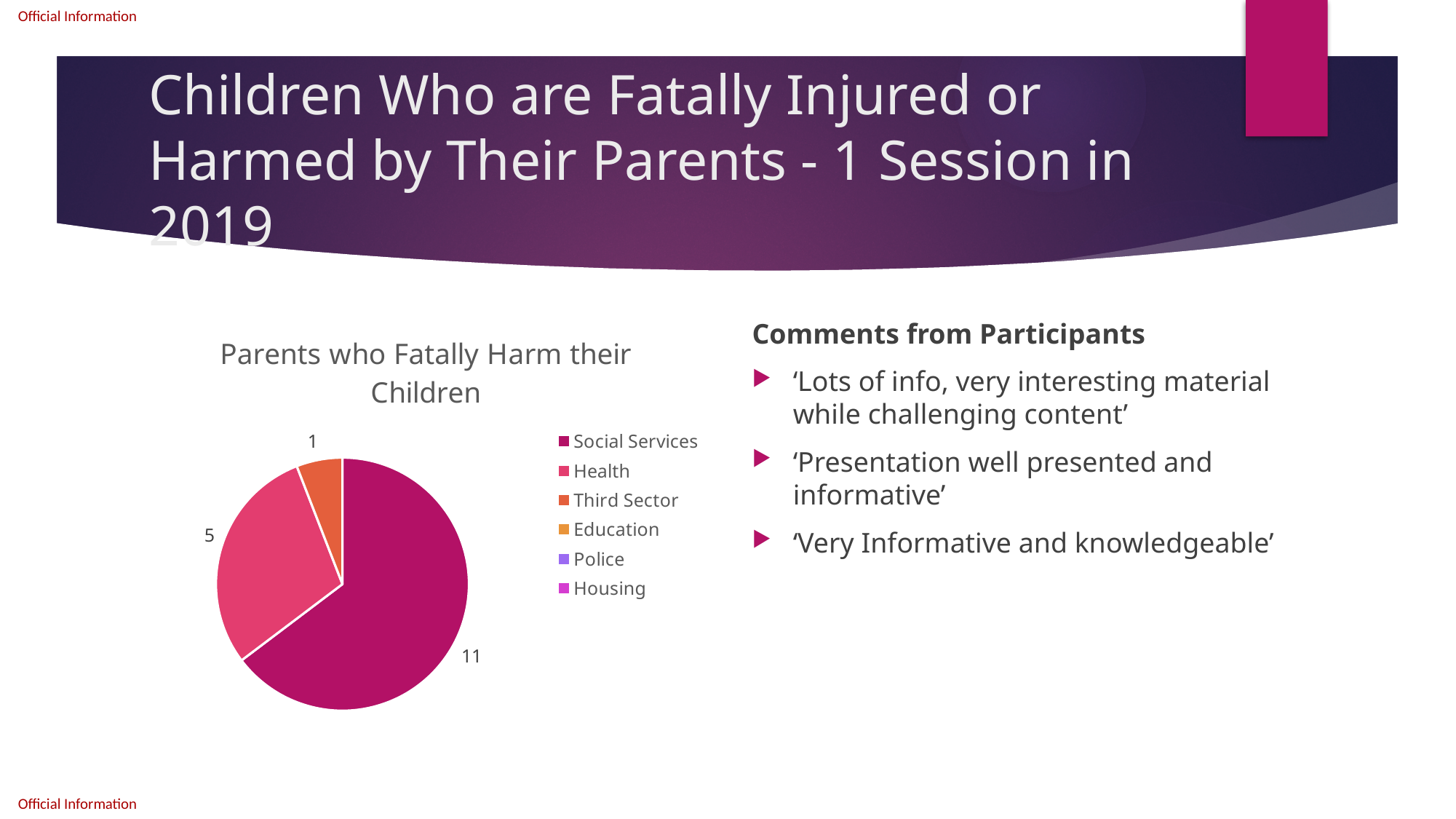
What is the title of the chart? Parents who Fatally Harm their Children Which of the labelled slices in the pie chart is the smallest? Third Sector How many categories does the legend of the pie chart list? 6 What type of chart is shown on the slide? pie chart What is the value for Third Sector in the pie chart? 1 What is the difference between the Health value and the Third Sector value? 4 What is the value for Health in the pie chart? 5 Which category has the largest slice in the pie chart? Social Services What is the value for Social Services in the pie chart? 11 What is the difference between the Social Services value and the Health value? 6 Which is larger, the Health slice or the Third Sector slice? Health